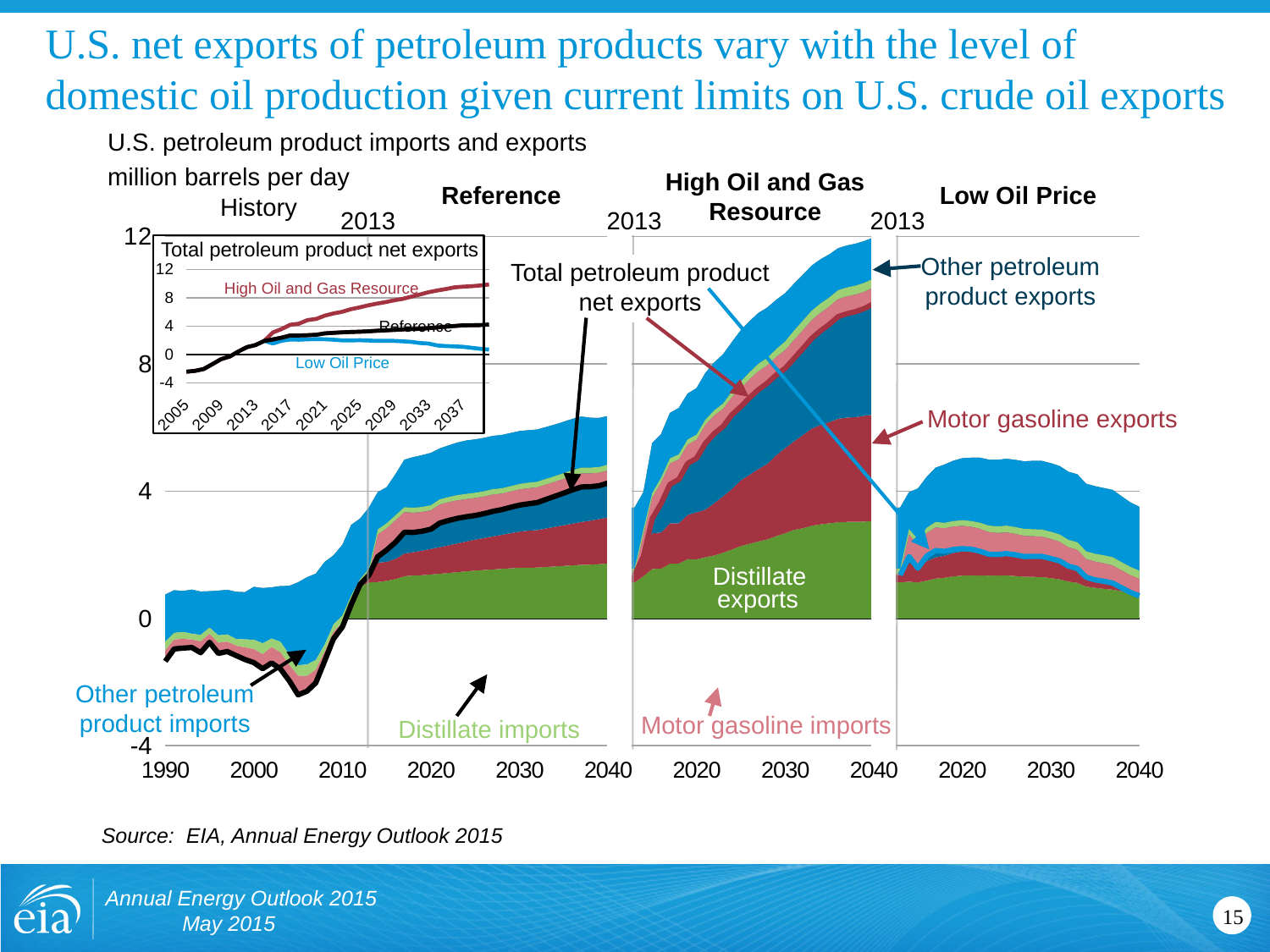
What unit is used on the main chart's y-axis? million barrels per day In the inset chart 'Total petroleum product net exports', which scenario has the highest net exports in 2037? High Oil and Gas Resource In the inset chart 'Total petroleum product net exports', does the High Oil and Gas Resource line rise or fall from 2013 to 2037? rises What kind of chart is the main chart showing U.S. petroleum product imports and exports? area chart In the inset chart 'Total petroleum product net exports', is the Reference value in 2037 greater or less than 8? less In the main chart's Reference panel, is total petroleum product net exports in 1990 greater or less than 0? less How many scenario panels does the main chart show for the projection period? 3 In the inset chart 'Total petroleum product net exports', is the High Oil and Gas Resource value in 2037 greater or less than 8? greater In the inset chart 'Total petroleum product net exports', which scenario has the lowest net exports in 2037? Low Oil Price In the inset chart 'Total petroleum product net exports', how many scenario lines are plotted? 3 What kind of chart is the inset chart titled 'Total petroleum product net exports'? line chart